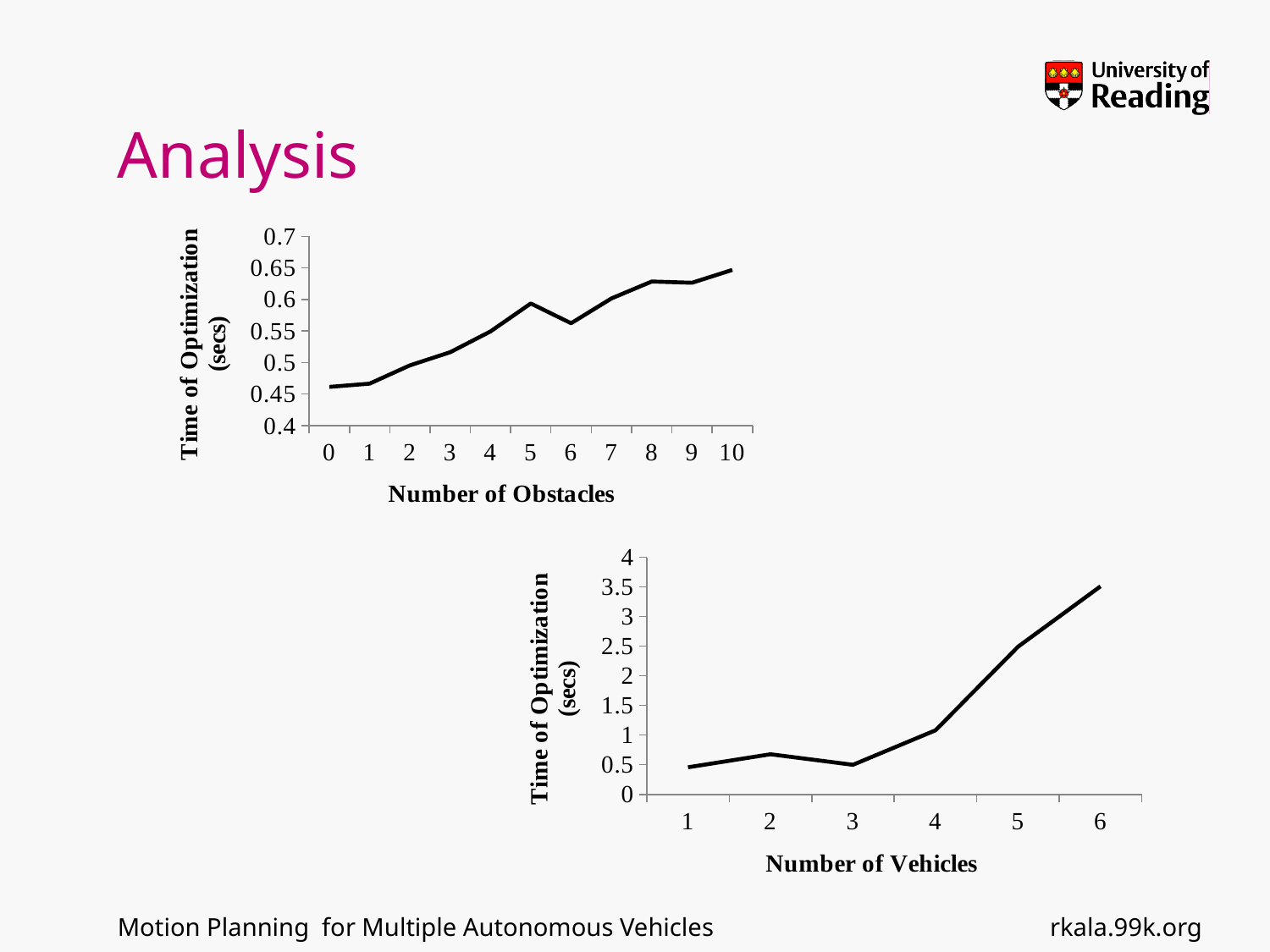
In the bottom chart (Number of Vehicles), how many data points are plotted along the x axis? 6 In the bottom chart (Number of Vehicles), is the value for 6 vehicles greater or less than 3? greater In the top chart (Number of Obstacles), which has the larger time of optimization, 5 obstacles or 6 obstacles? 5 obstacles In the top chart (Number of Obstacles), is the value for 5 obstacles greater or less than 0.55? greater In the top chart (Number of Obstacles), is the value for 0 obstacles greater or less than 0.5? less What kind of chart is the top chart, 'Number of Obstacles'? line chart In the top chart (Number of Obstacles), how many data points are plotted along the x axis? 11 In the bottom chart (Number of Vehicles), at which number of vehicles is the time of optimization highest? 6 What kind of chart is the bottom chart, 'Number of Vehicles'? line chart In the bottom chart (Number of Vehicles), does the time of optimization generally rise or fall as the number of vehicles increases? rise In the top chart (Number of Obstacles), at which number of obstacles is the time of optimization highest? 10